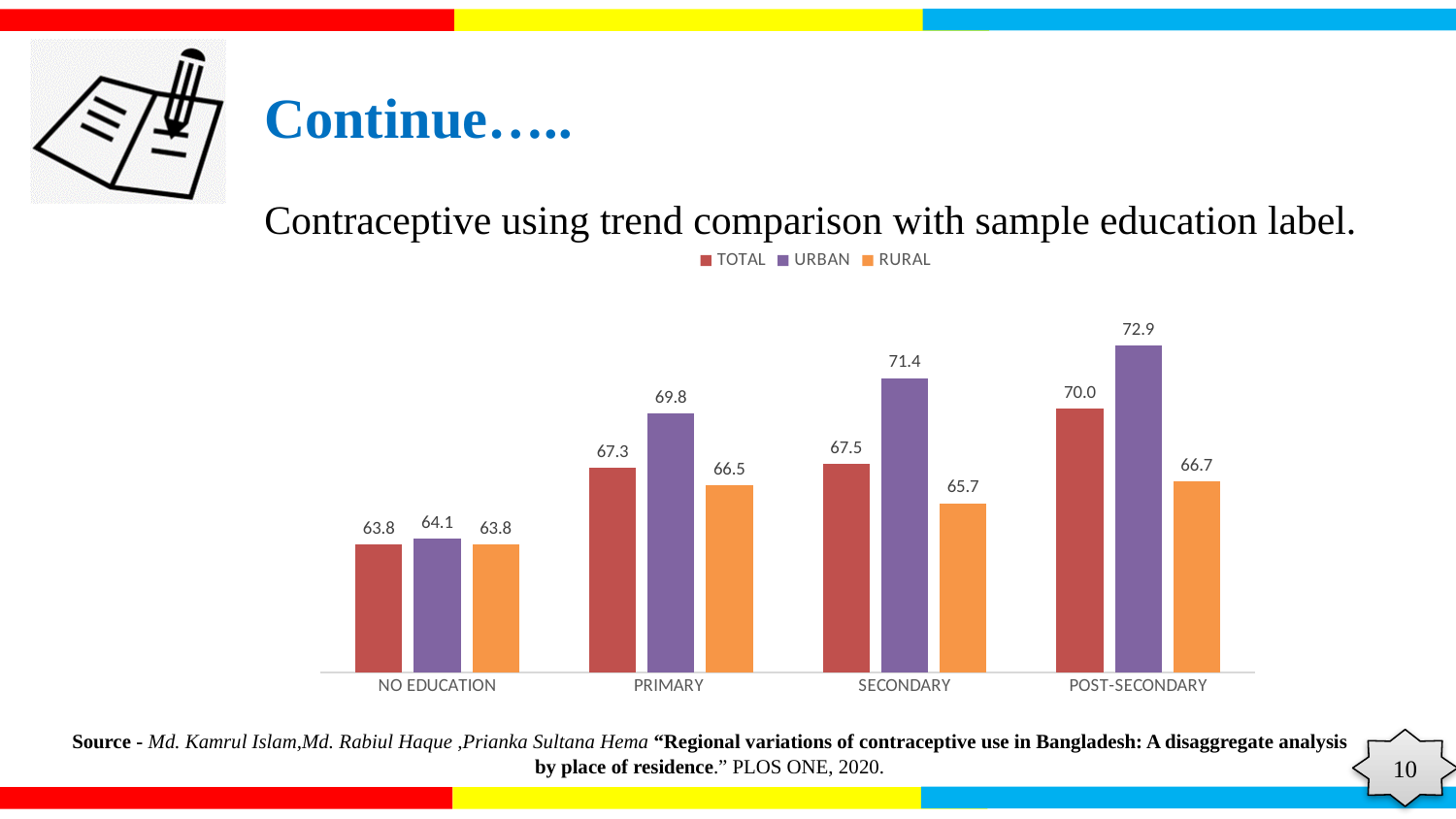
Which is larger, the RURAL value for PRIMARY or the RURAL value for SECONDARY? RURAL value for PRIMARY Which education category has the highest URBAN value? POST-SECONDARY Which education category has the lowest TOTAL value? NO EDUCATION What is the URBAN value for SECONDARY? 71.4 What is the TOTAL value for POST-SECONDARY? 70.0 How many education categories are shown on the x axis? 4 What kind of chart is shown on the slide? Bar chart What is the difference between the URBAN and RURAL values for POST-SECONDARY? 6.2 Do the URBAN values rise or fall from NO EDUCATION to POST-SECONDARY? Rise What is the title of the chart? Contraceptive using trend comparison with sample education label. How many series does the legend list? 3 What is the RURAL value for PRIMARY? 66.5